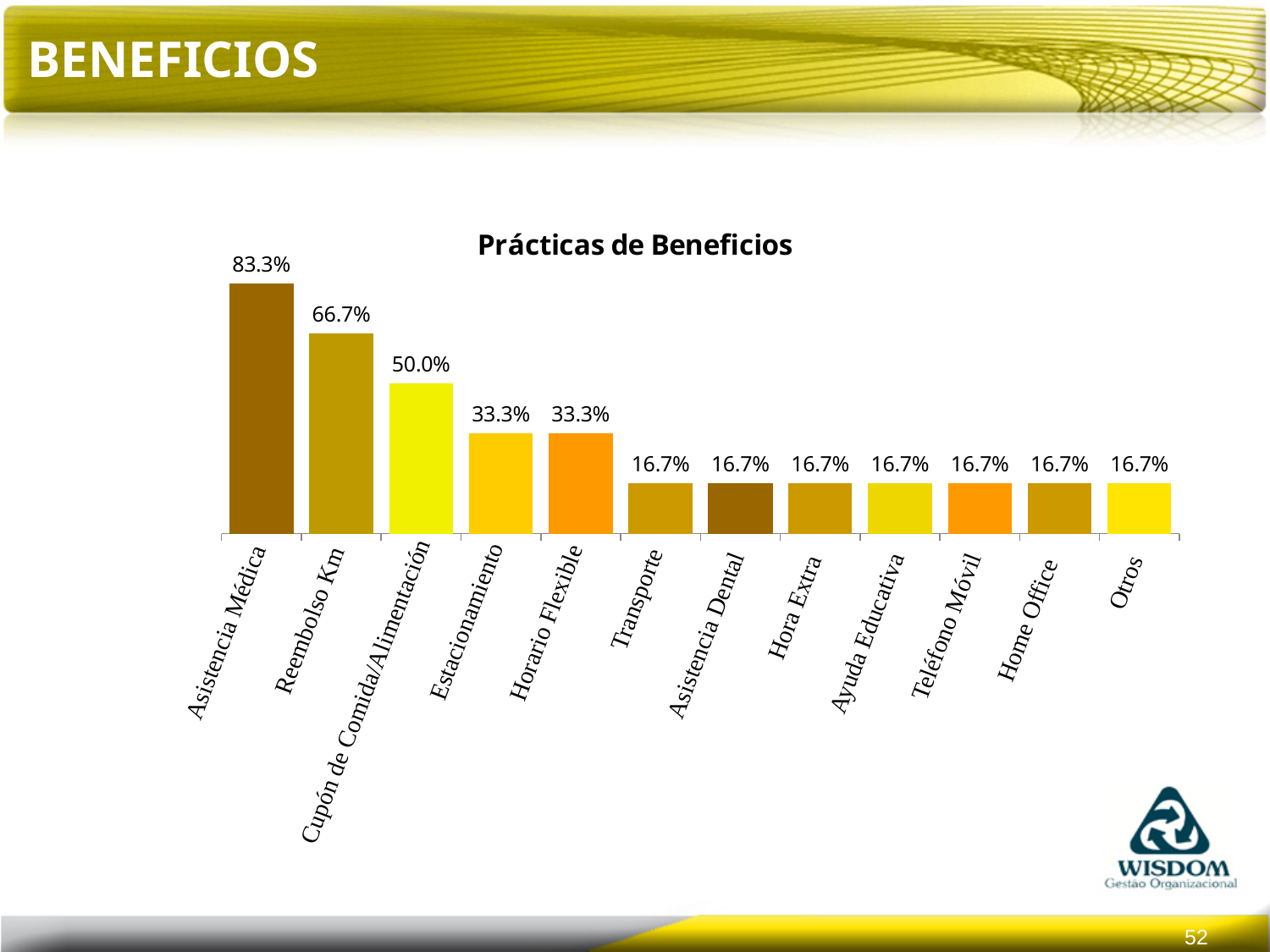
What kind of chart is shown on the slide? Bar chart How many categories are shown in the chart? 12 What is the value for Horario Flexible? 33.3% Which category has the highest value? Asistencia Médica What is the title of the chart? Prácticas de Beneficios What is the difference between the values for Cupón de Comida/Alimentación and Transporte? 33.3% What is the value for Asistencia Médica? 83.3% What is the value for Home Office? 16.7% What is the difference between the values for Asistencia Médica and Reembolso Km? 16.6% What is the value for Reembolso Km? 66.7% What is the value for Cupón de Comida/Alimentación? 50.0% Which is larger, the value for Estacionamiento or the value for Hora Extra? Estacionamiento